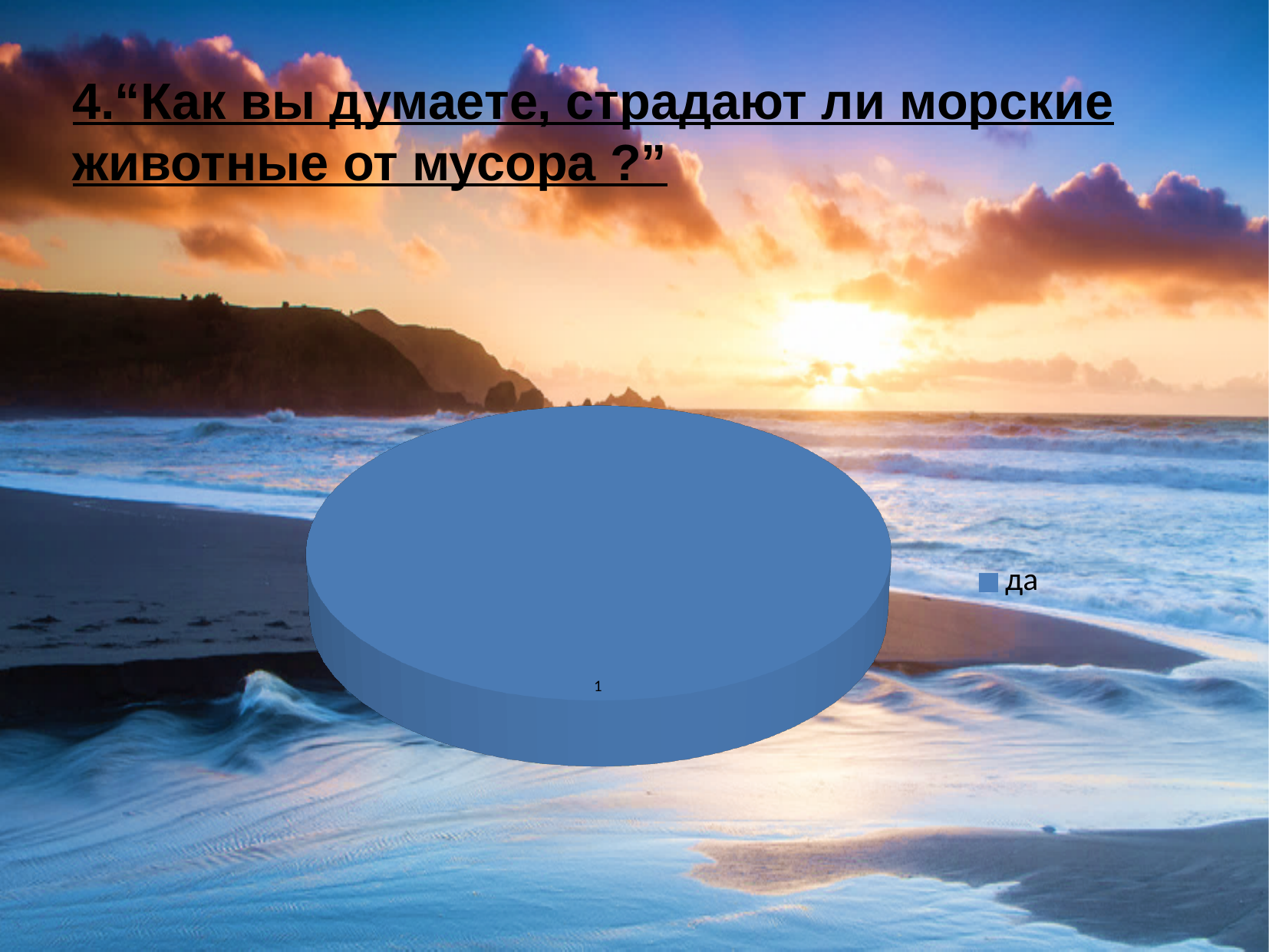
What share of the pie does the slice "да" take up? 100% How many slices does the pie chart have? 1 What kind of chart is shown on the slide? pie chart How many entries does the legend of the pie chart list? 1 What is the value for the category "да" in the pie chart? 1 What is the only category listed in the legend of the pie chart? да What colour is the slice for "да" in the pie chart? blue What is the data label shown on the pie chart's slice? 1